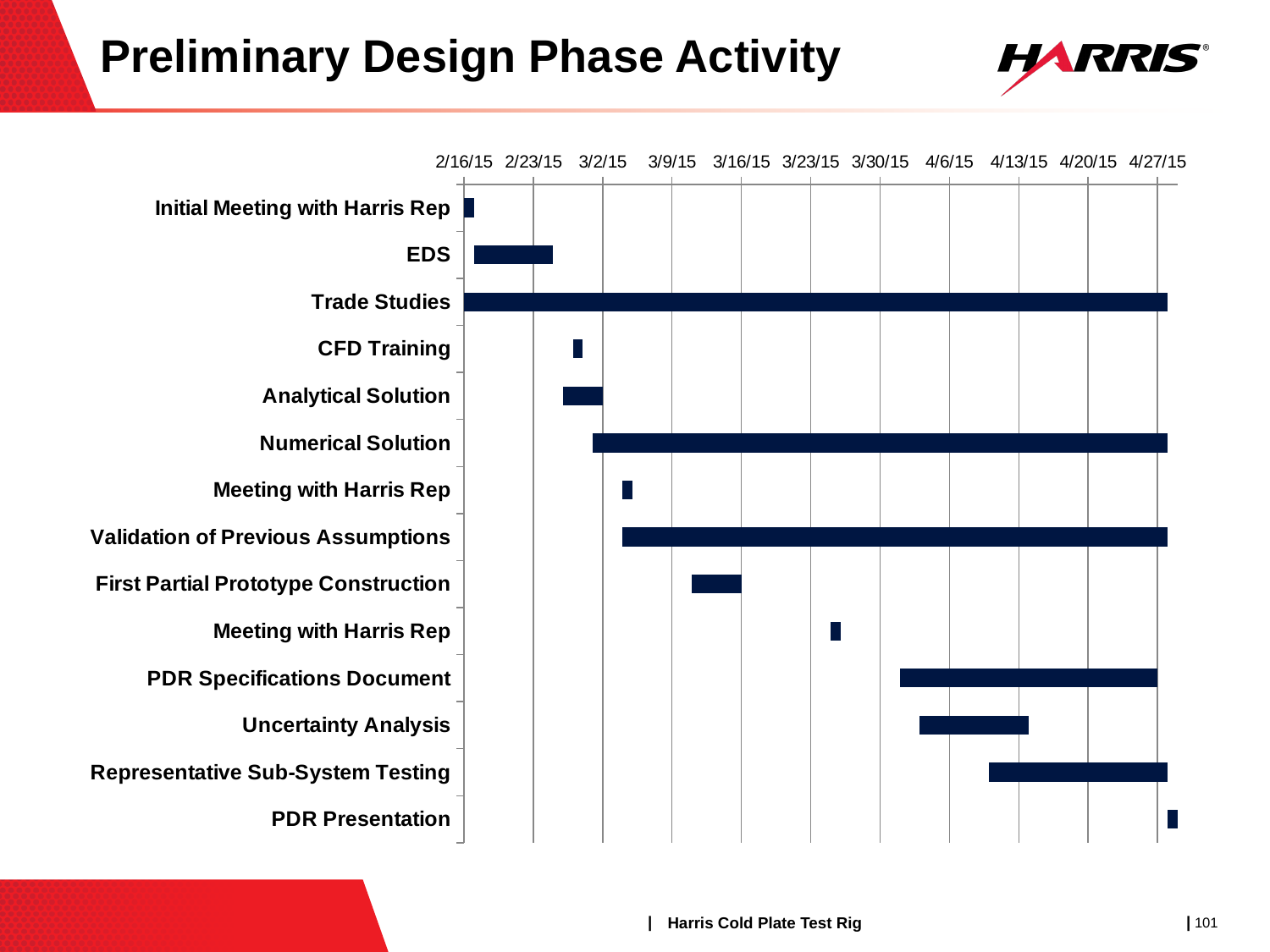
Which activity has the longest bar in the chart? Trade Studies Which activity's bar starts earliest on the timeline? Trade Studies Does the bar for PDR Specifications Document start before or after 4/6/15? before Which activity's bar is positioned latest on the timeline? PDR Presentation Does the bar for Uncertainty Analysis end before or after 4/20/15? before How many activities are listed on the vertical axis of the chart? 14 What is the first date label shown on the horizontal axis? 2/16/15 Does the bar for First Partial Prototype Construction start before or after 3/9/15? after Which bar is longer, Numerical Solution or Uncertainty Analysis? Numerical Solution Which bar is longer, EDS or Analytical Solution? EDS What kind of chart is shown on the slide? Bar chart (Gantt chart)